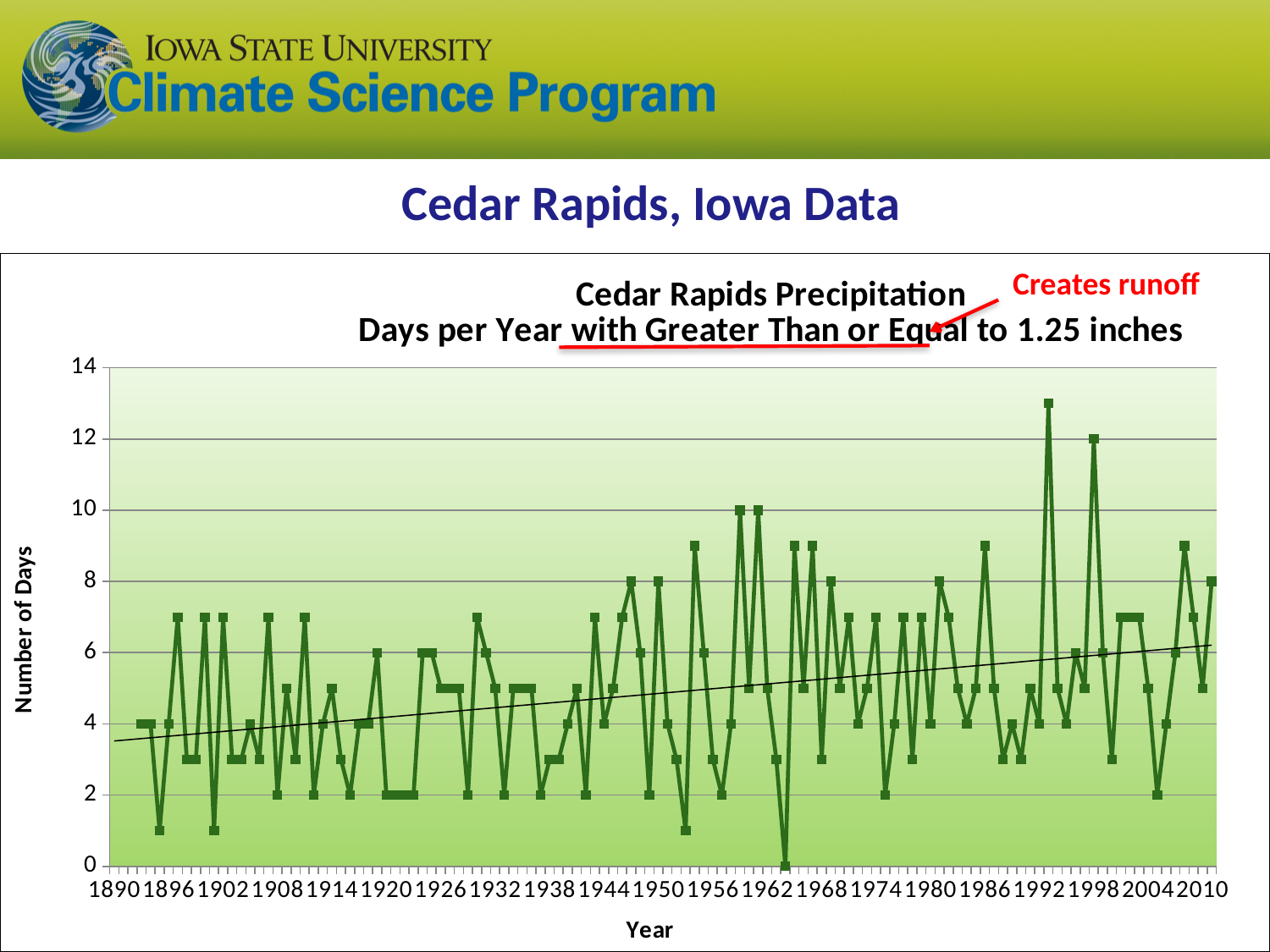
Is the highest value plotted on the chart greater or less than 12? greater What does the red annotation next to the chart title say? Creates runoff What kind of chart is shown on the slide? line chart Is the trend line value at 1890 greater or less than 4? less Does the trend line for the number of days rise or fall from 1890 to 2010? rises What is the maximum value shown on the y-axis? 14 Is the peak value near 1998 greater or less than 10? greater What is the lowest value plotted on the chart? 0 What is the title of the chart? Cedar Rapids Precipitation Days per Year with Greater Than or Equal to 1.25 inches